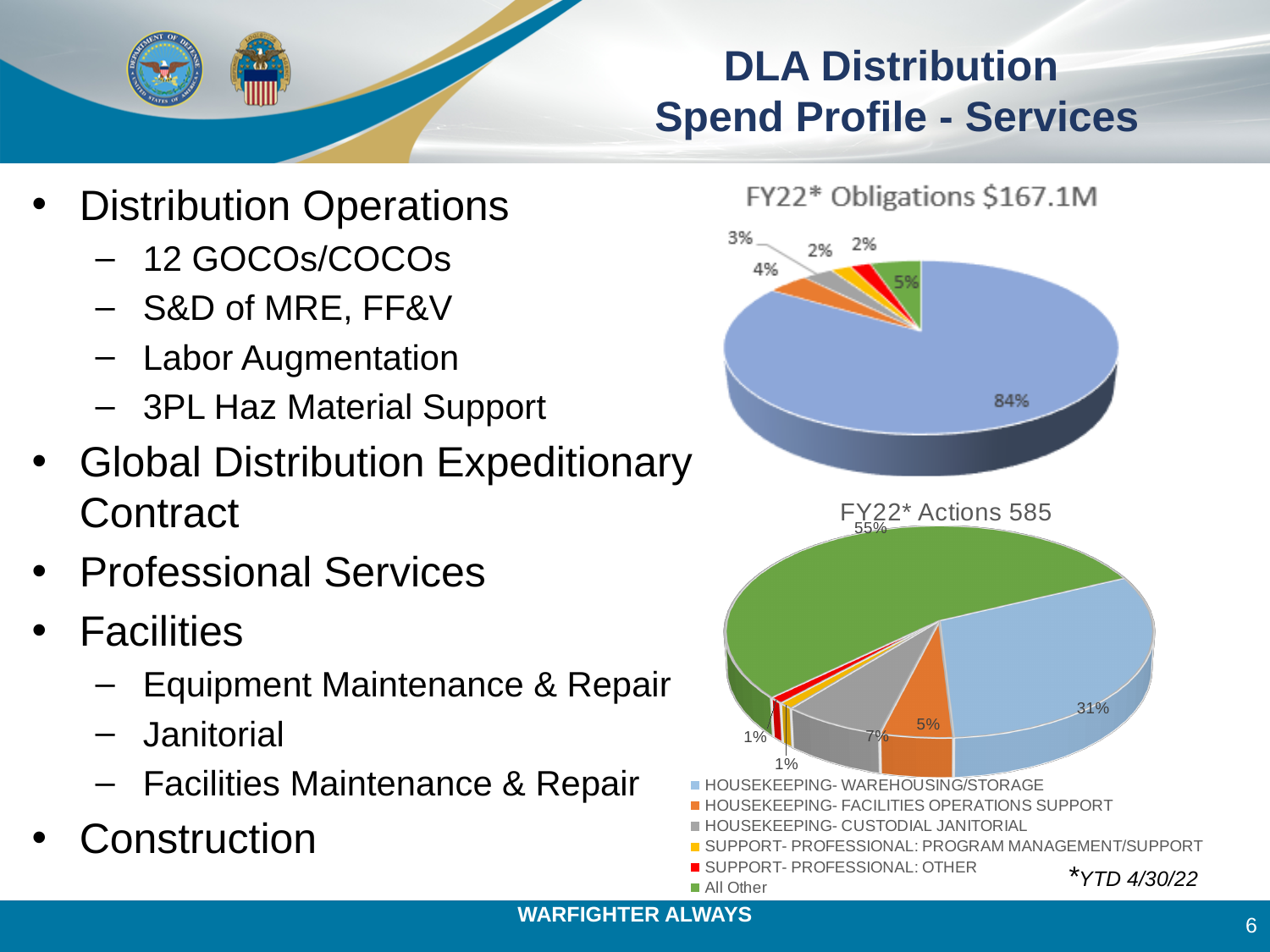
In the 'FY22* Obligations $167.1M' chart, what percentage does the largest slice show? 84% How many entries does the legend below the pie charts list? 6 In the 'FY22* Actions 585' chart, what share is labelled on the blue 'HOUSEKEEPING- WAREHOUSING/STORAGE' slice? 31% In the 'FY22* Obligations $167.1M' chart, what share is labelled on the green 'All Other' slice? 5% In the 'FY22* Actions 585' chart, what percentage does the largest slice show? 55% In the 'FY22* Actions 585' chart, what share is labelled on the gray 'HOUSEKEEPING- CUSTODIAL JANITORIAL' slice? 7% In the 'FY22* Actions 585' chart, what is the difference between the 55% slice and the 31% slice? 24% In the 'FY22* Obligations $167.1M' chart, what is the difference between the largest slice (84%) and the 'All Other' slice (5%)? 79% In the 'FY22* Actions 585' chart, which is larger: the 'All Other' slice or the 'HOUSEKEEPING- WAREHOUSING/STORAGE' slice? All Other What type of chart is the 'FY22* Obligations $167.1M' chart? Pie chart What is the title of the top pie chart on the slide? FY22* Obligations $167.1M